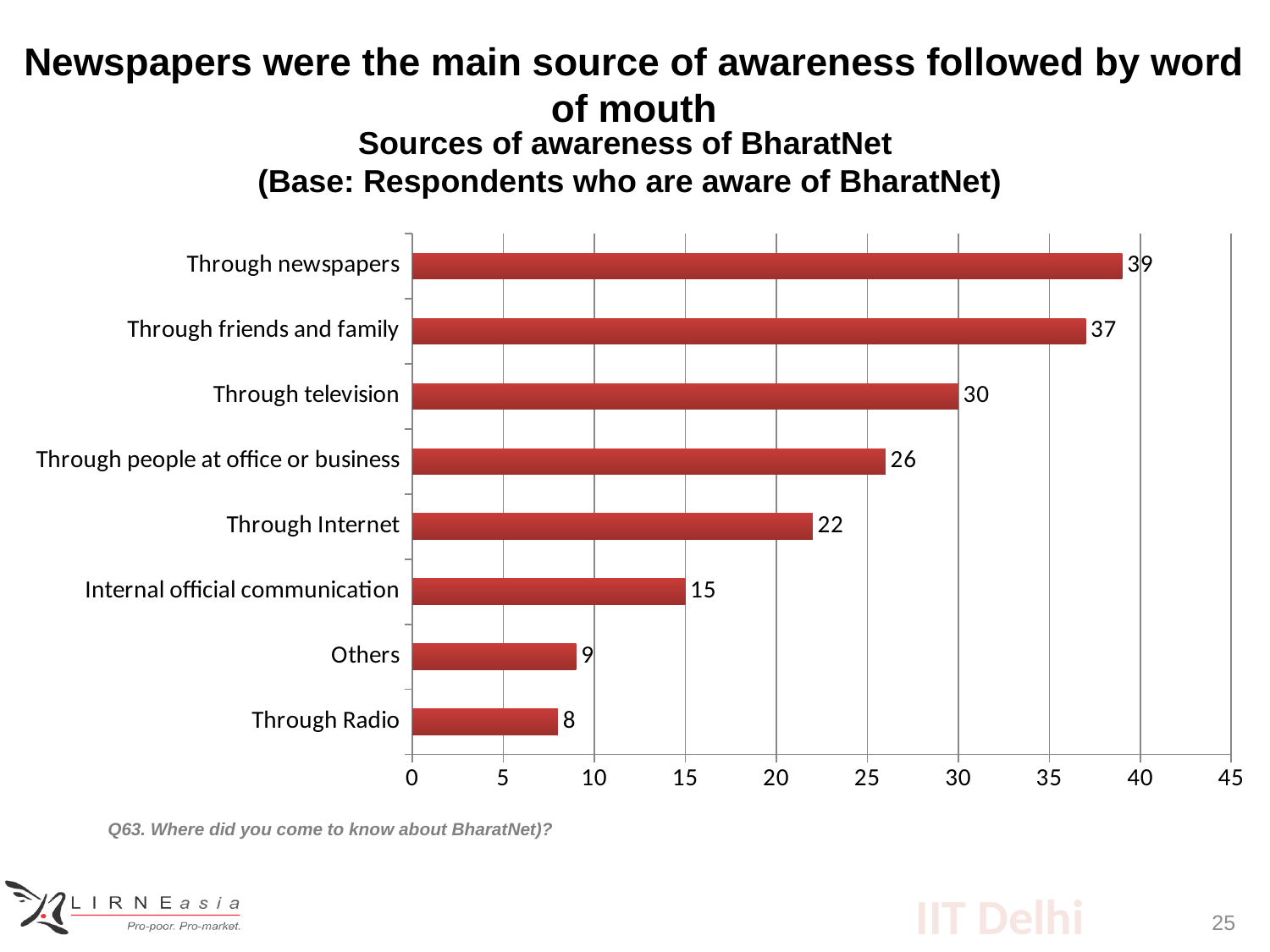
Which source of awareness has the lowest value? Through Radio What is the difference between the values for Through television and Through Internet? 8 What is the difference between the values for Through newspapers and Through friends and family? 2 What is the value for Through television? 30 Which source of awareness has the highest value? Through newspapers What kind of chart is shown on the slide? Bar chart Is the value for Through friends and family greater or less than 35? greater What is the value for Through newspapers? 39 What is the value for Internal official communication? 15 How many categories are shown in the chart? 8 What is the title of the chart? Sources of awareness of BharatNet (Base: Respondents who are aware of BharatNet) Which is larger, the value for Through people at office or business or the value for Through Internet? Through people at office or business